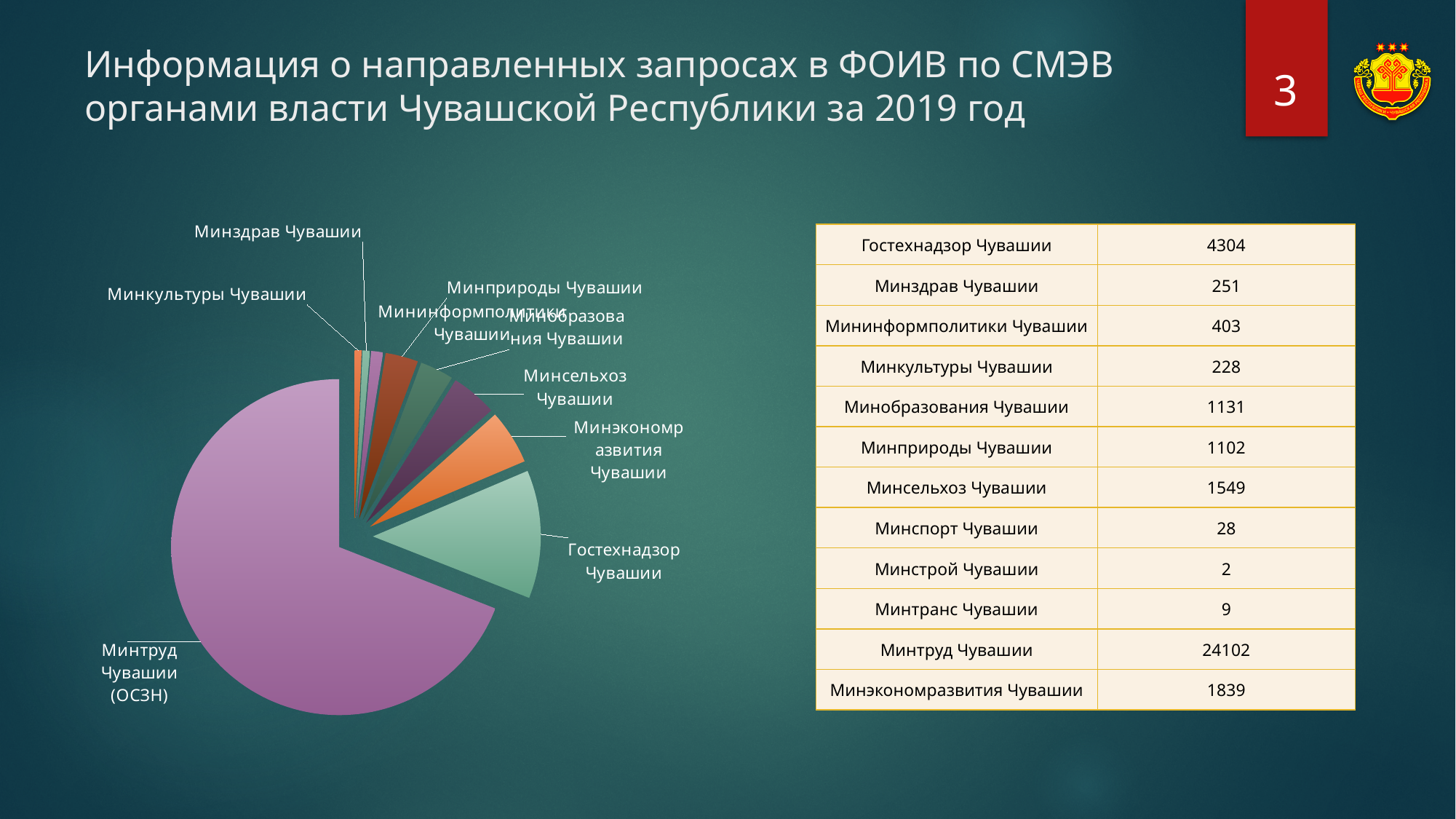
Which slice is larger in the pie chart: Минтруд Чувашии (ОСЗН) or Гостехнадзор Чувашии? Минтруд Чувашии (ОСЗН) Which slice is larger in the pie chart: Минсельхоз Чувашии or Минздрав Чувашии? Минсельхоз Чувашии Using the values in the table, what is the difference between Гостехнадзор Чувашии and Минэкономразвития Чувашии? 2465 Which category has the largest slice in the pie chart? Минтруд Чувашии (ОСЗН) How many organisations are listed in the table on the slide? 12 According to the table on the slide, which organisation has the lowest value? Минстрой Чувашии According to the table on the slide, what is the value for Гостехнадзор Чувашии? 4304 What kind of chart is shown on the slide? pie chart Which slice is larger in the pie chart: Гостехнадзор Чувашии or Минэкономразвития Чувашии? Гостехнадзор Чувашии According to the table on the slide, what is the value for Минсельхоз Чувашии? 1549 What colour is the largest slice of the pie chart? purple According to the table on the slide, what is the value for Минтруд Чувашии? 24102